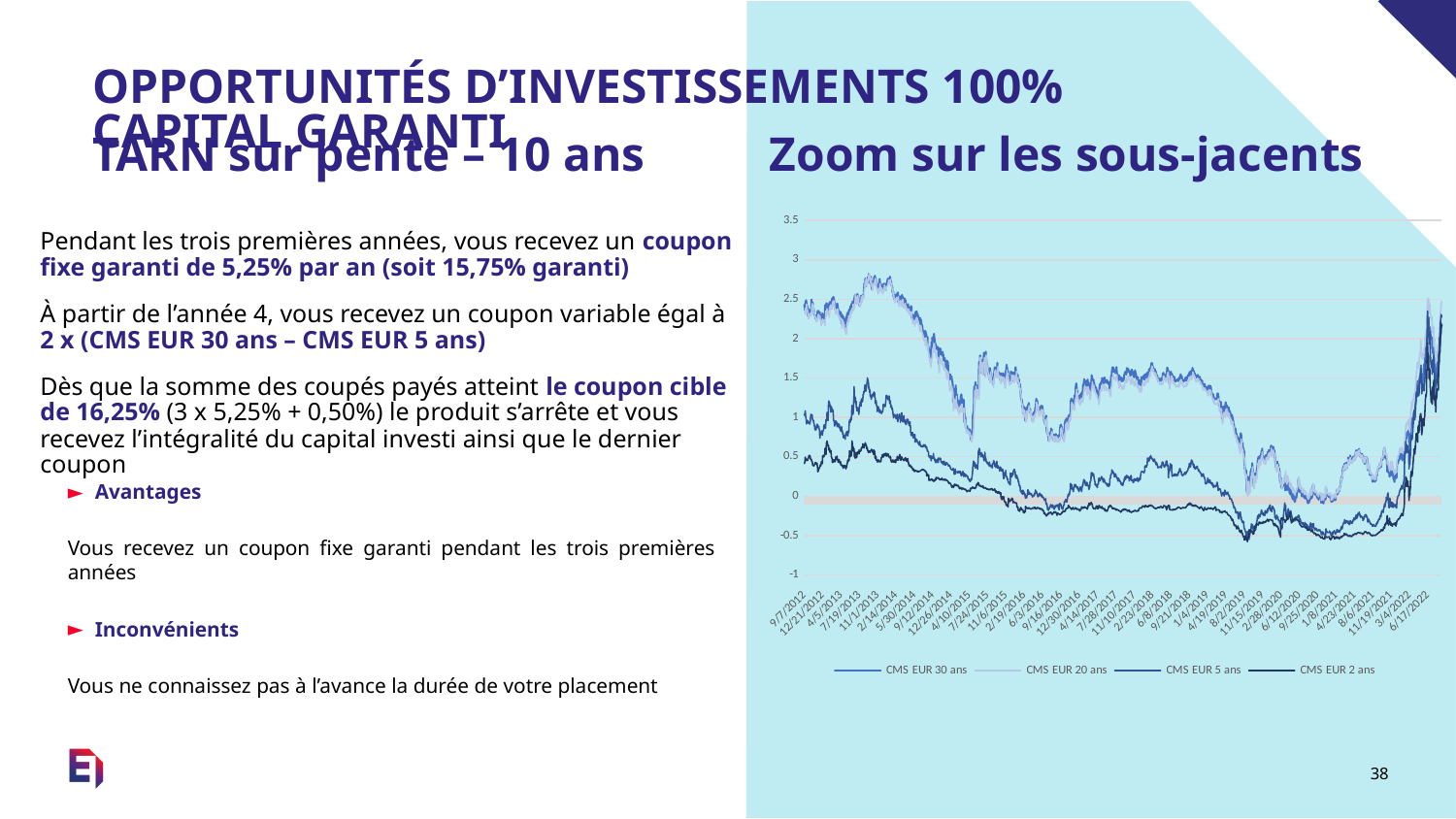
Is the value for CMS EUR 2 ans around 1/8/2020 greater or less than 0? less What is the last date shown on the x axis of the chart? 6/17/2022 What is the highest value shown on the y axis of the chart? 3.5 What kind of chart is shown on the slide? Line chart Do the CMS EUR 30 ans values rise or fall between 9/7/2012 and 1/8/2020? fall What is the title of the chart? Zoom sur les sous-jacents Which series are listed in the chart legend? CMS EUR 30 ans, CMS EUR 20 ans, CMS EUR 5 ans, CMS EUR 2 ans Do the series values rise or fall at the right end of the chart, in 2022? rise What is the lowest value shown on the y axis of the chart? -1 What is the first date shown on the x axis of the chart? 9/7/2012 How many series does the chart legend list? 4 Is the value for CMS EUR 30 ans at the start of the chart (9/7/2012) greater or less than 2? greater